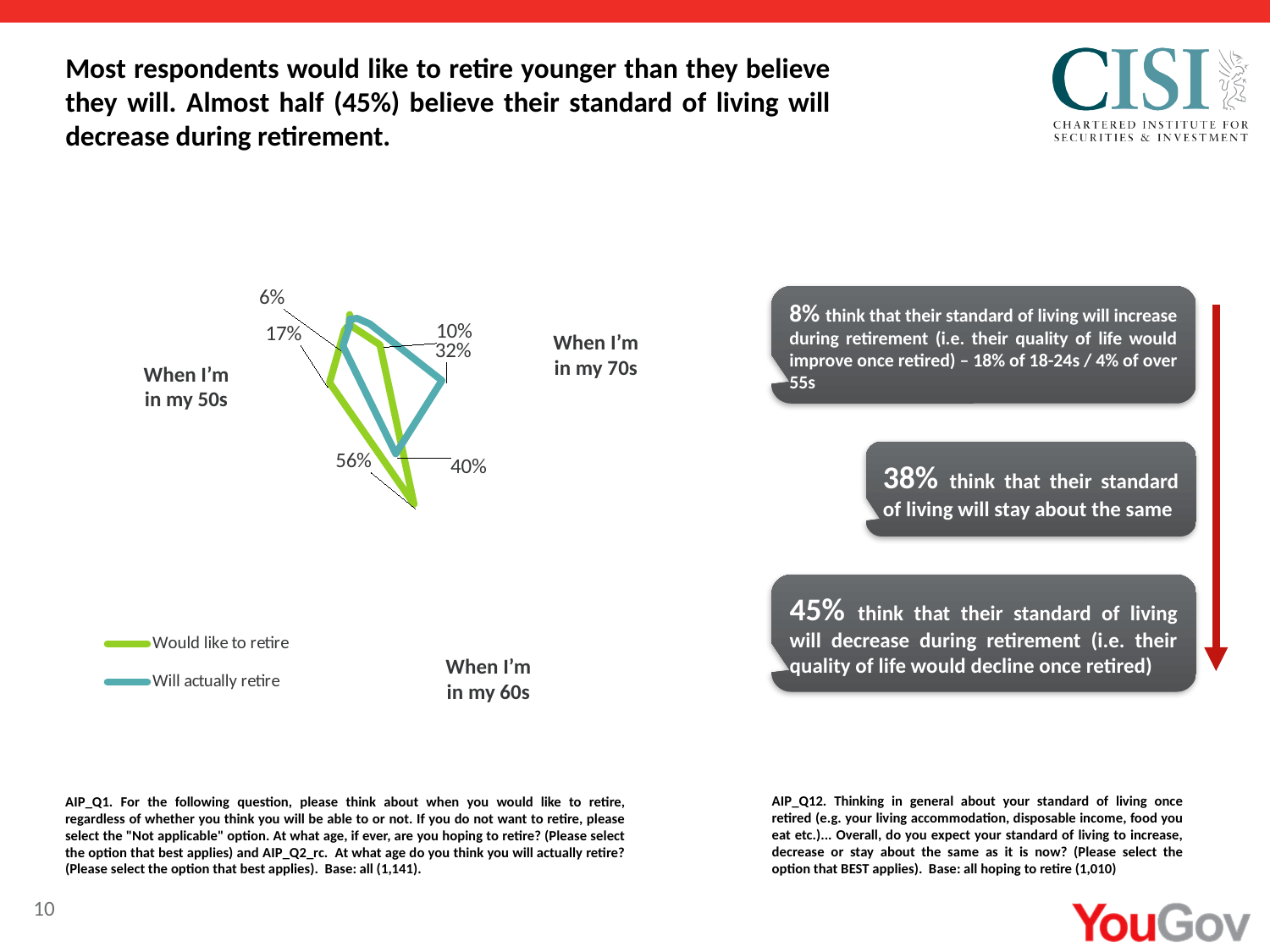
What percentage of respondents would like to retire when they are in their 70s? 10% Which retirement age category has the highest value for the 'Will actually retire' series? When I'm in my 60s How many series does the chart legend list? 2 What is the difference between the 'Would like to retire' and 'Will actually retire' values for 'When I'm in my 60s'? 16 percentage points What percentage of respondents think they will actually retire when they are in their 70s? 32% What percentage of respondents would like to retire when they are in their 60s? 56% Which retirement age category has the highest value for the 'Would like to retire' series? When I'm in my 60s What type of chart is used to show when respondents would like to retire versus when they will actually retire? Radar chart What percentage of respondents would like to retire when they are in their 50s? 17% What is the difference between the 'Will actually retire' and 'Would like to retire' values for 'When I'm in my 70s'? 22 percentage points What percentage of respondents think they will actually retire when they are in their 60s? 40% For 'When I'm in my 70s', which series has the larger value: 'Would like to retire' or 'Will actually retire'? Will actually retire